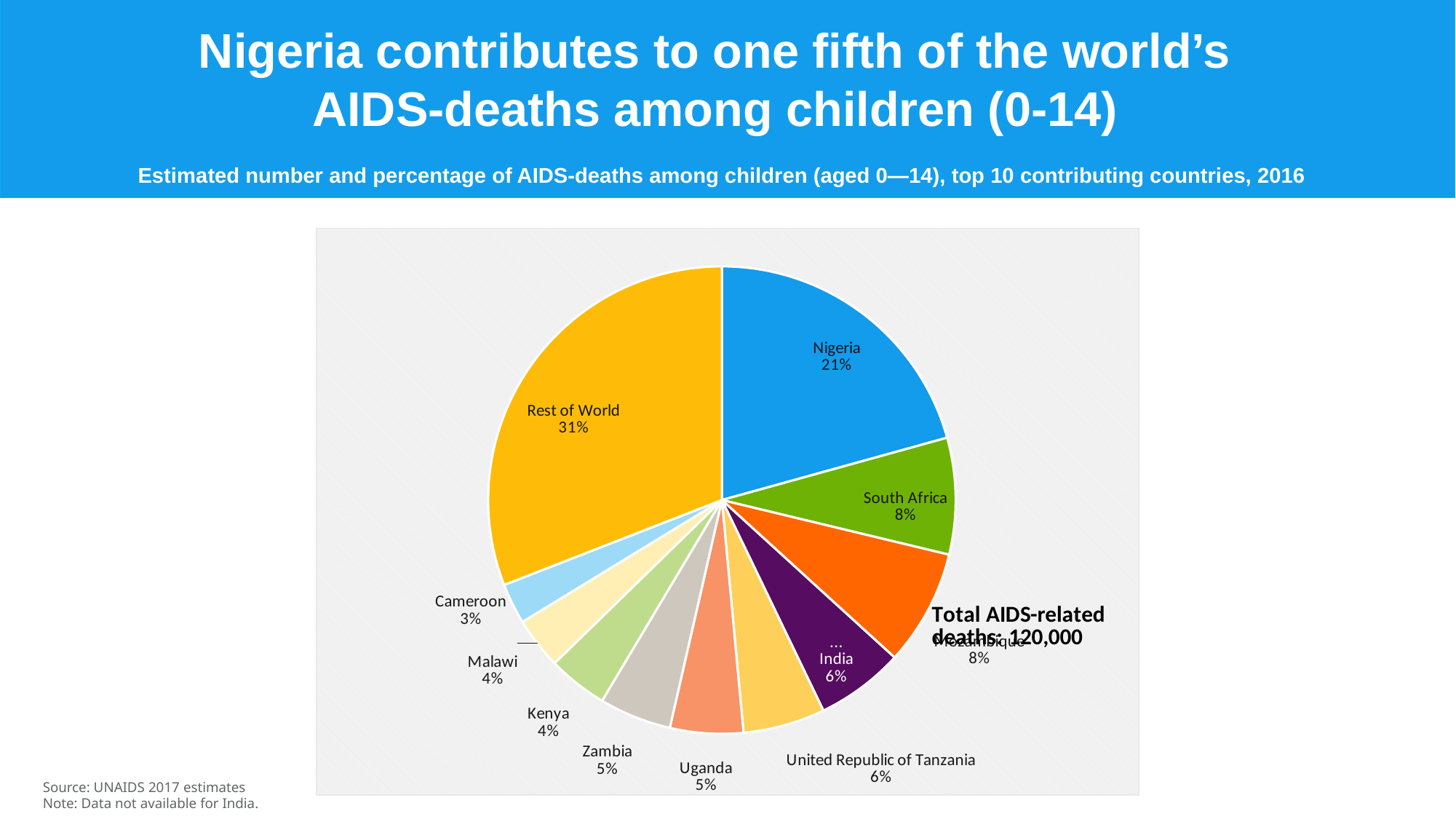
What percentage of AIDS-deaths among children does Nigeria account for in the pie chart? 21% What percentage is shown for Cameroon? 3% Which country has the largest slice in the pie chart? Nigeria Which has the larger share, Zambia or Kenya? Zambia What percentage is shown for South Africa? 8% What is the total number of AIDS-related deaths stated on the chart? 120,000 Which labelled country has the smallest slice in the pie chart? Cameroon How many percentage points larger is Nigeria's share than South Africa's? 13 percentage points What share of the pie chart is labelled Rest of World? 31% What type of chart is shown on the slide? Pie chart What colour is the Nigeria slice in the pie chart? Blue What percentage is shown for Uganda? 5%